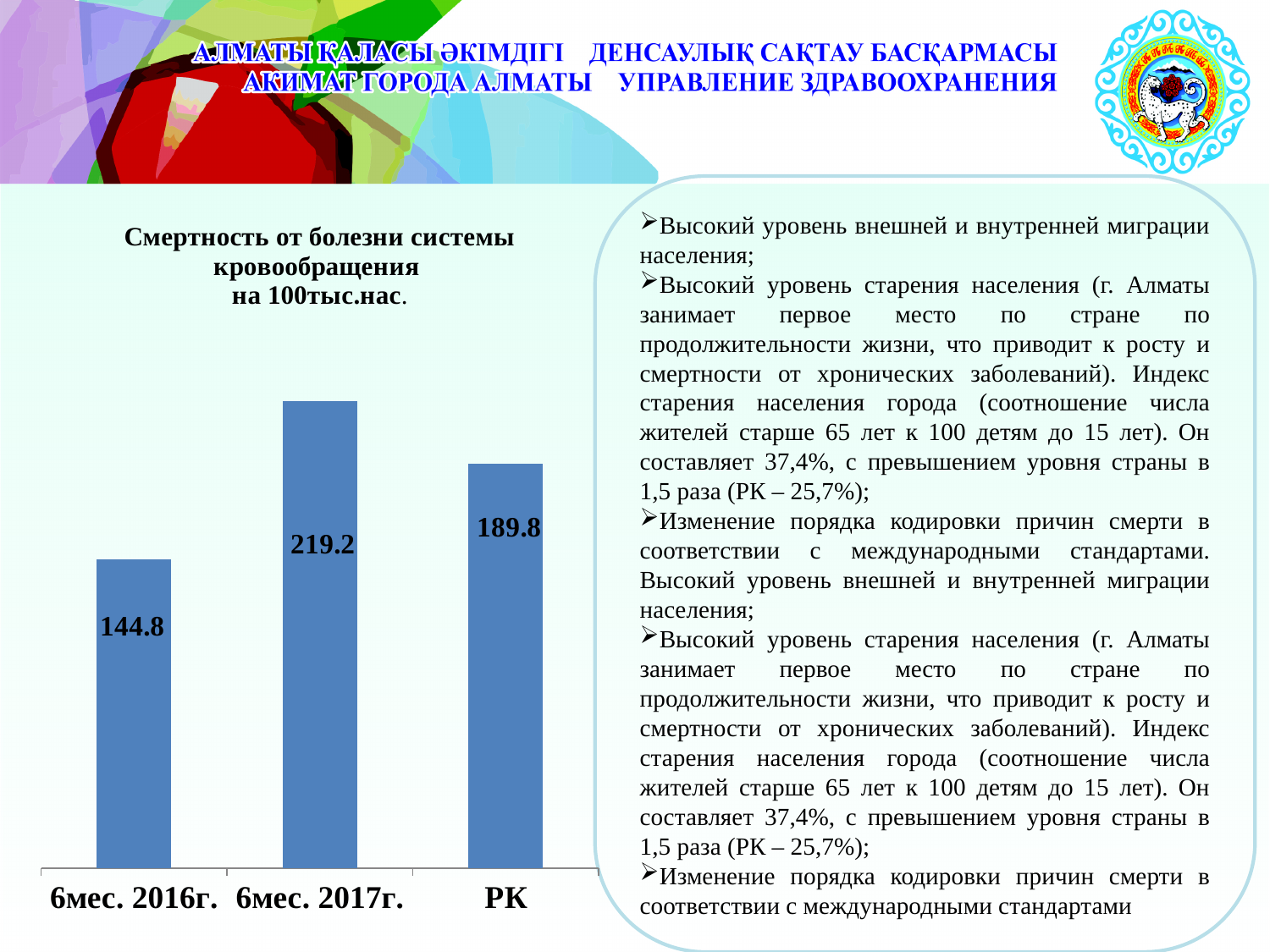
Which category has the lowest value? 6мес. 2016г. What is the difference between the values for 6мес. 2017г. and 6мес. 2016г.? 74.4 What is the value for 6мес. 2016г.? 144.8 What is the value for 6мес. 2017г.? 219.2 Which is larger, the value for РК or the value for 6мес. 2016г.? РК What is the title of the chart? Смертность от болезни системы кровообращения на 100тыс.нас. How many categories are shown on the chart? 3 What is the value for РК? 189.8 What is the difference between the values for 6мес. 2017г. and РК? 29.4 Which category has the highest value? 6мес. 2017г. What colour are the bars in the chart? blue What kind of chart is shown on the slide? bar chart